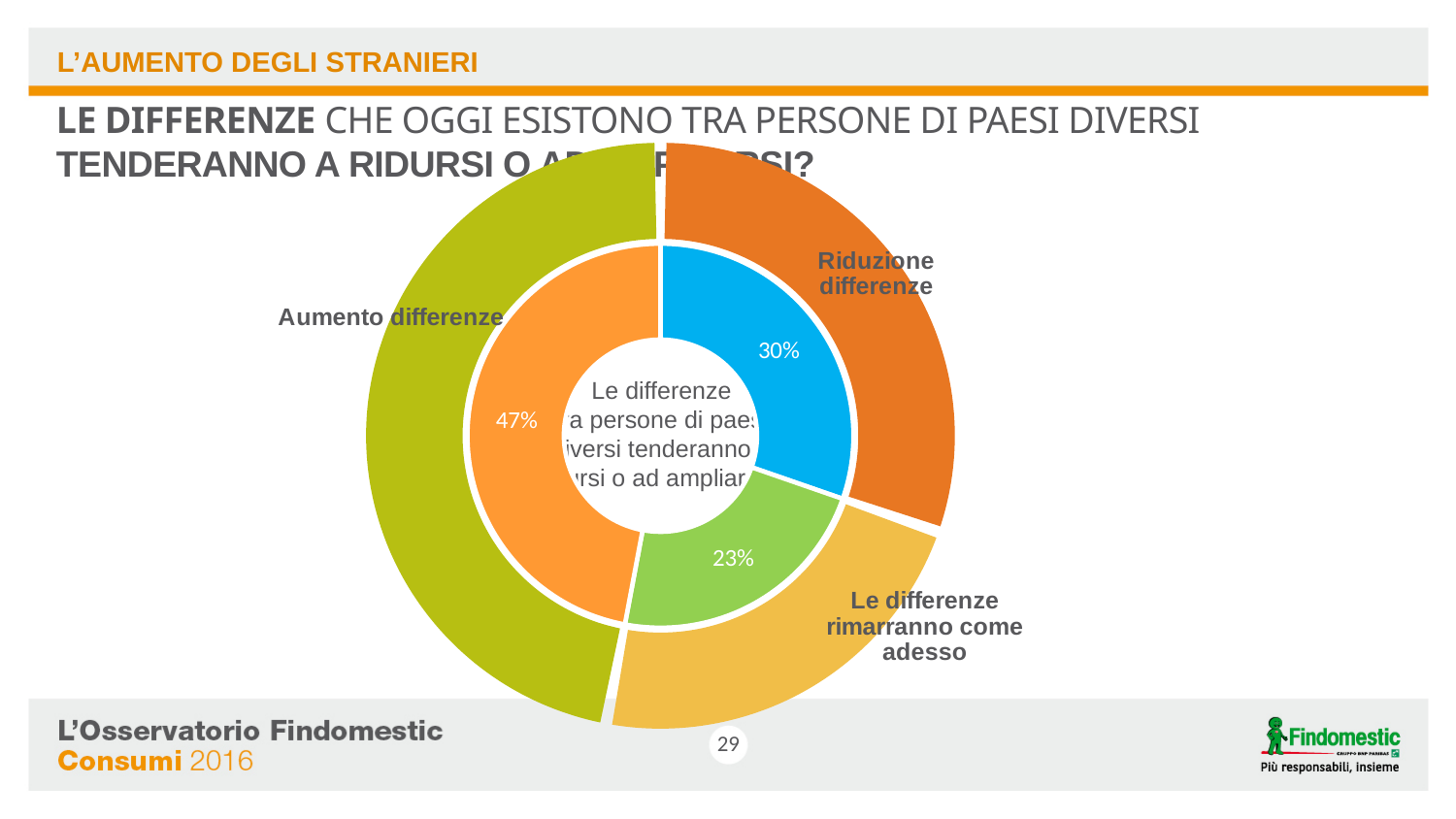
What percentage of respondents answered "Riduzione differenze"? 30% What kind of chart is shown on the slide? Doughnut chart What colour is the inner segment for "Riduzione differenze"? Blue What percentage of respondents answered "Le differenze rimarranno come adesso"? 23% What is the combined share of "Riduzione differenze" and "Le differenze rimarranno come adesso"? 53% What percentage of respondents answered "Aumento differenze"? 47% What is the difference in percentage points between "Aumento differenze" and "Riduzione differenze"? 17 What is the difference in percentage points between "Riduzione differenze" and "Le differenze rimarranno come adesso"? 7 How many response categories are shown in the chart? 3 Which response has the largest share in the chart? Aumento differenze Which is larger: the share for "Riduzione differenze" or the share for "Le differenze rimarranno come adesso"? Riduzione differenze Which response has the smallest share in the chart? Le differenze rimarranno come adesso